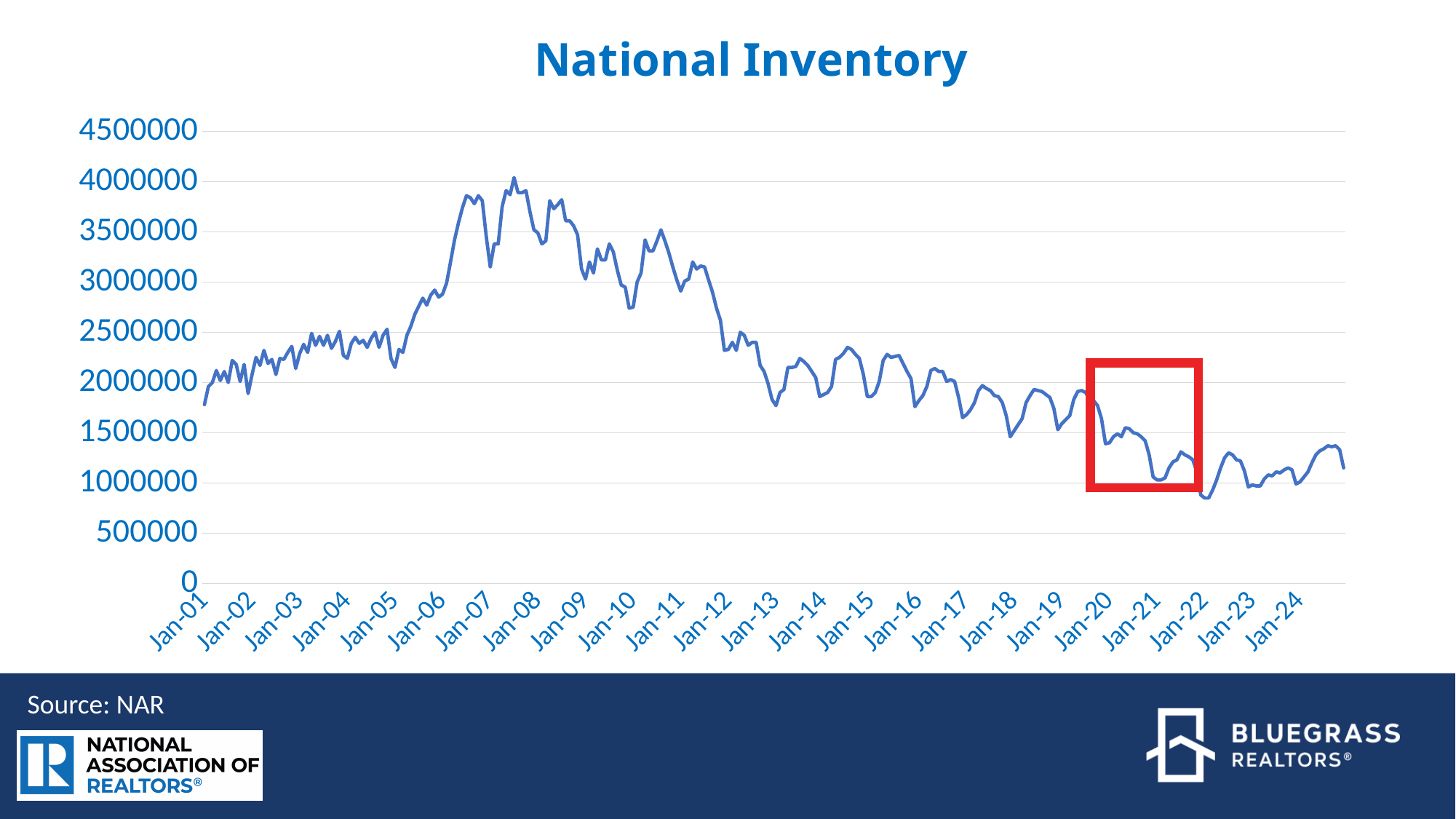
Is the value at Jan-10 greater or less than 2500000? greater How many year labels are shown on the x axis? 24 Near which x-axis label does the line reach its lowest point? Jan-22 Does the line generally rise or fall between Jan-08 and Jan-12? fall Is the value at Jan-01 greater or less than 2000000? less Is the value at Jan-13 greater or less than 2000000? less Near which x-axis label does the line reach its highest point? Jan-08 What kind of chart is shown on the slide? line chart What is the title of the chart? National Inventory What source is cited for the chart? NAR